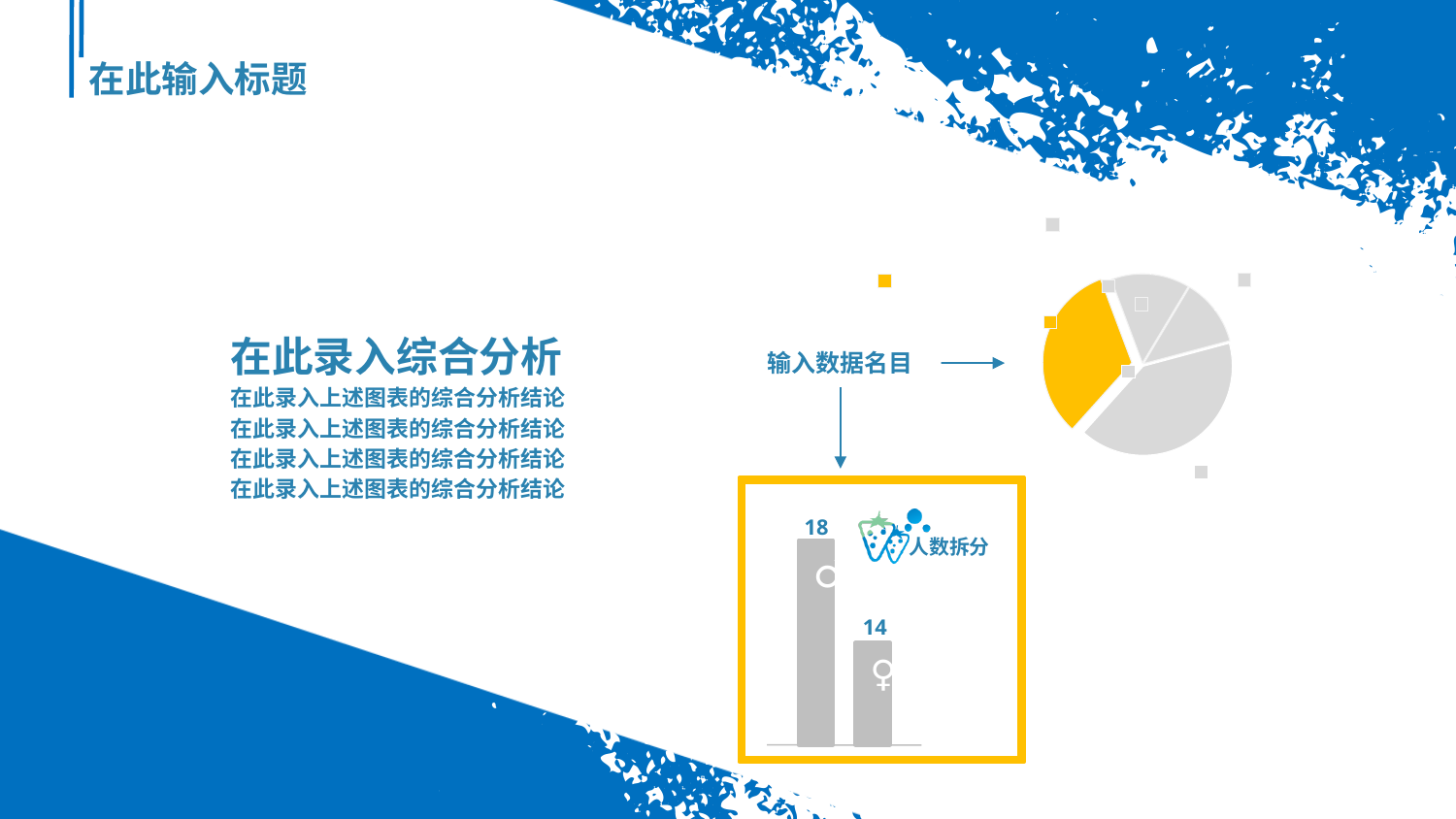
In the bar chart titled 人数拆分, what is the difference between the two bars? 4 What is the title of the bar chart inside the yellow frame? 人数拆分 In the bar chart titled 人数拆分, what is the value of the bar with the male symbol? 18 In the bar chart titled 人数拆分, is the male bar or the female bar larger? The male bar In the bar chart titled 人数拆分, what is the value of the bar with the female symbol? 14 In the pie chart in the upper right, what colour is the highlighted slice? Yellow What kind of chart is the one titled 人数拆分 inside the yellow frame? Bar chart In the bar chart titled 人数拆分, which bar is the shortest? The female bar (14) How many bars are in the bar chart titled 人数拆分? 2 What kind of chart is shown in the upper right of the slide? Pie chart In the bar chart titled 人数拆分, which bar is the tallest? The male bar (18) In the bar chart titled 人数拆分, do the values rise or fall from left to right? Fall